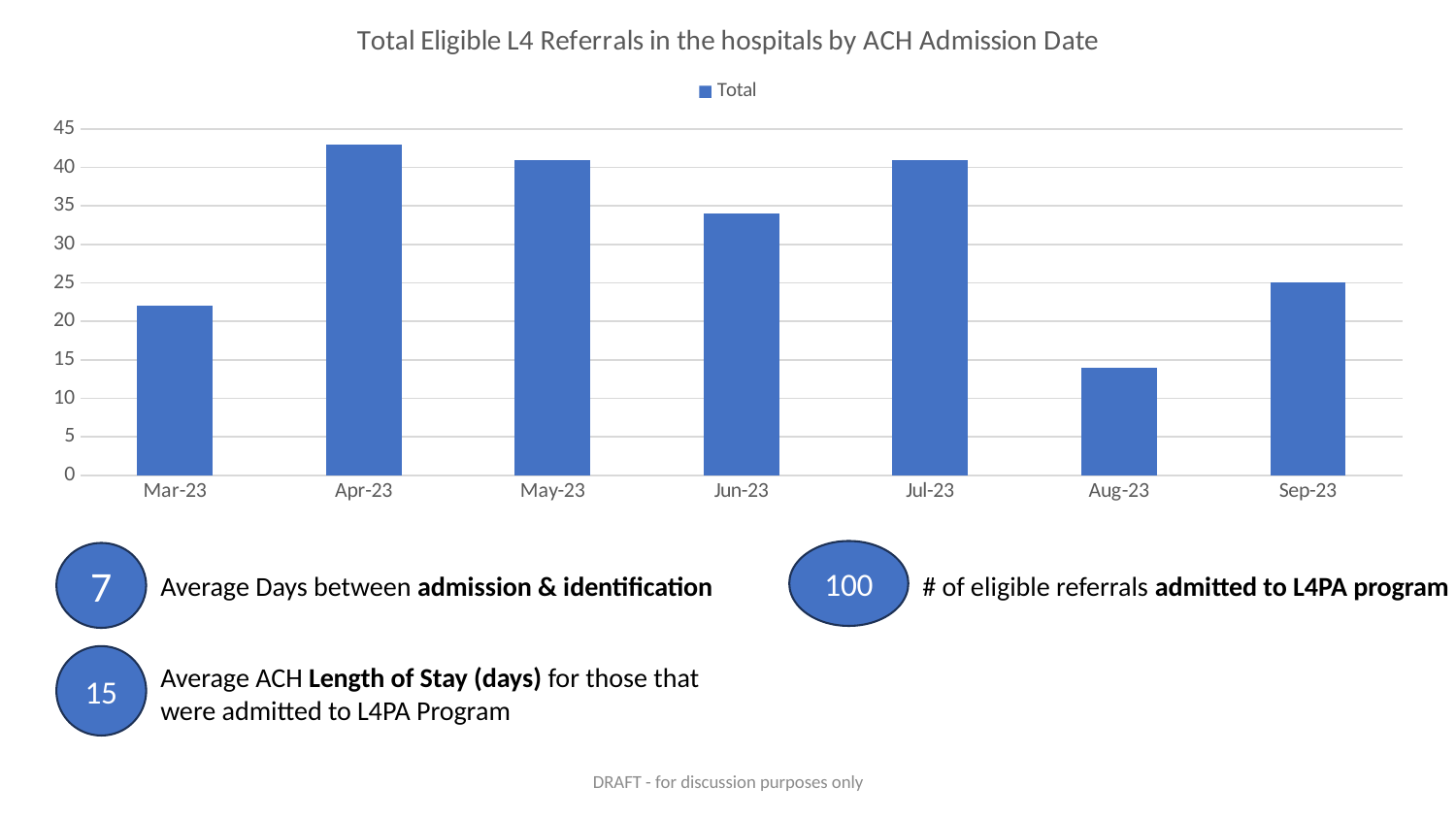
Is the value for Jun-23 greater or less than 35? less How many series does the legend list? 1 What is the title of the chart? Total Eligible L4 Referrals in the hospitals by ACH Admission Date What is the name of the series shown in the legend? Total Which month has the lowest total? Aug-23 Is the value for Mar-23 greater or less than 20? greater Is the value for Aug-23 greater or less than 15? less Which month has the highest total? Apr-23 Which is larger, the value for Jun-23 or the value for Jul-23? Jul-23 Does the value rise or fall from Jul-23 to Aug-23? fall How many months are shown on the x axis? 7 What type of chart is shown on the slide? bar chart